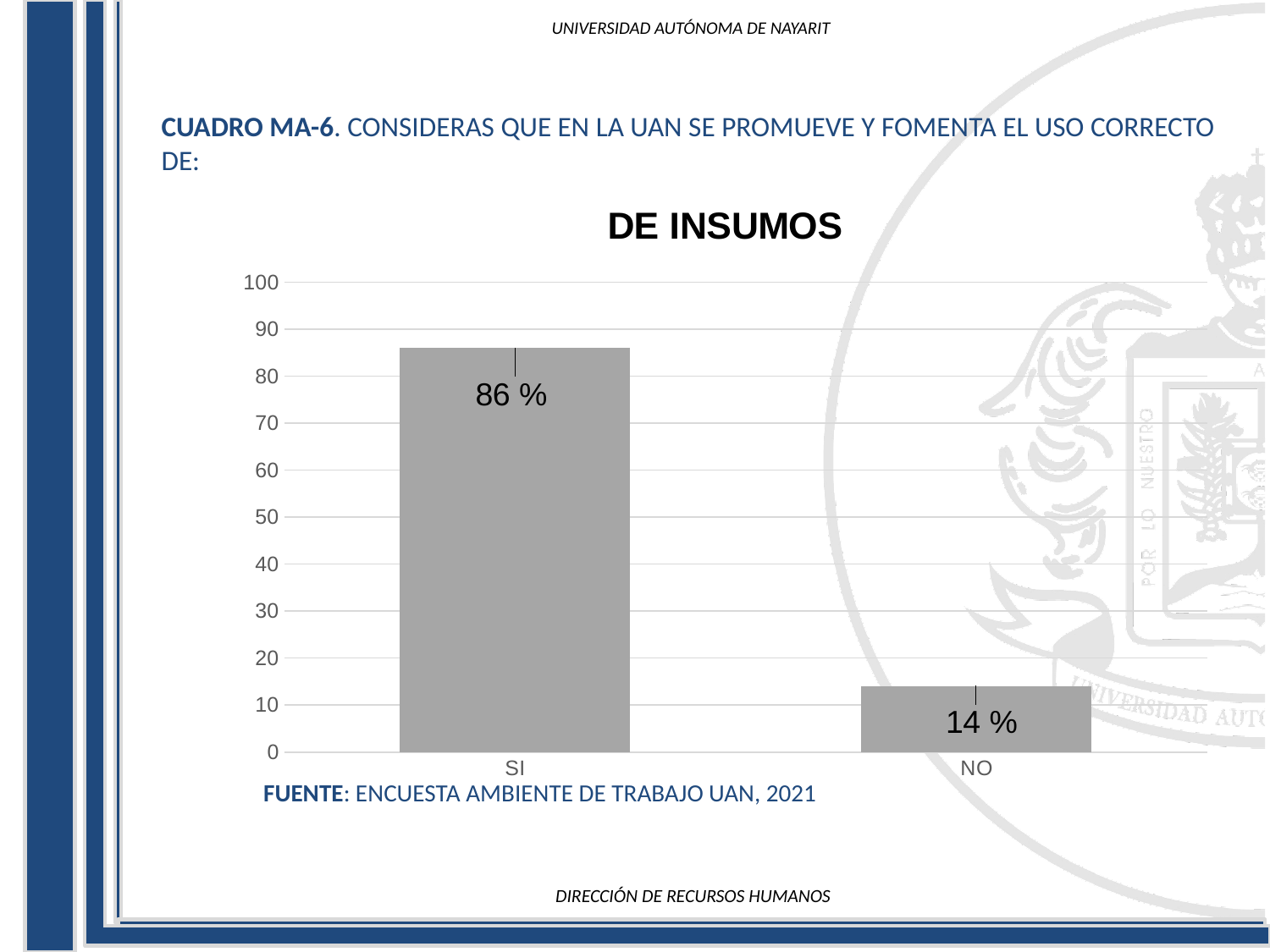
What is the maximum value shown on the vertical axis? 100 Which category has the lowest value? NO Is the value for NO greater or less than 20? less What is the value for SI? 86 % Is the value for SI greater or less than 80? greater What is the difference between the values for SI and NO? 72 % What is the value for NO? 14 % Which is larger, the value for SI or the value for NO? SI What is the title of the chart? DE INSUMOS How many categories are shown in the chart? 2 What kind of chart is shown? bar chart Which category has the highest value? SI